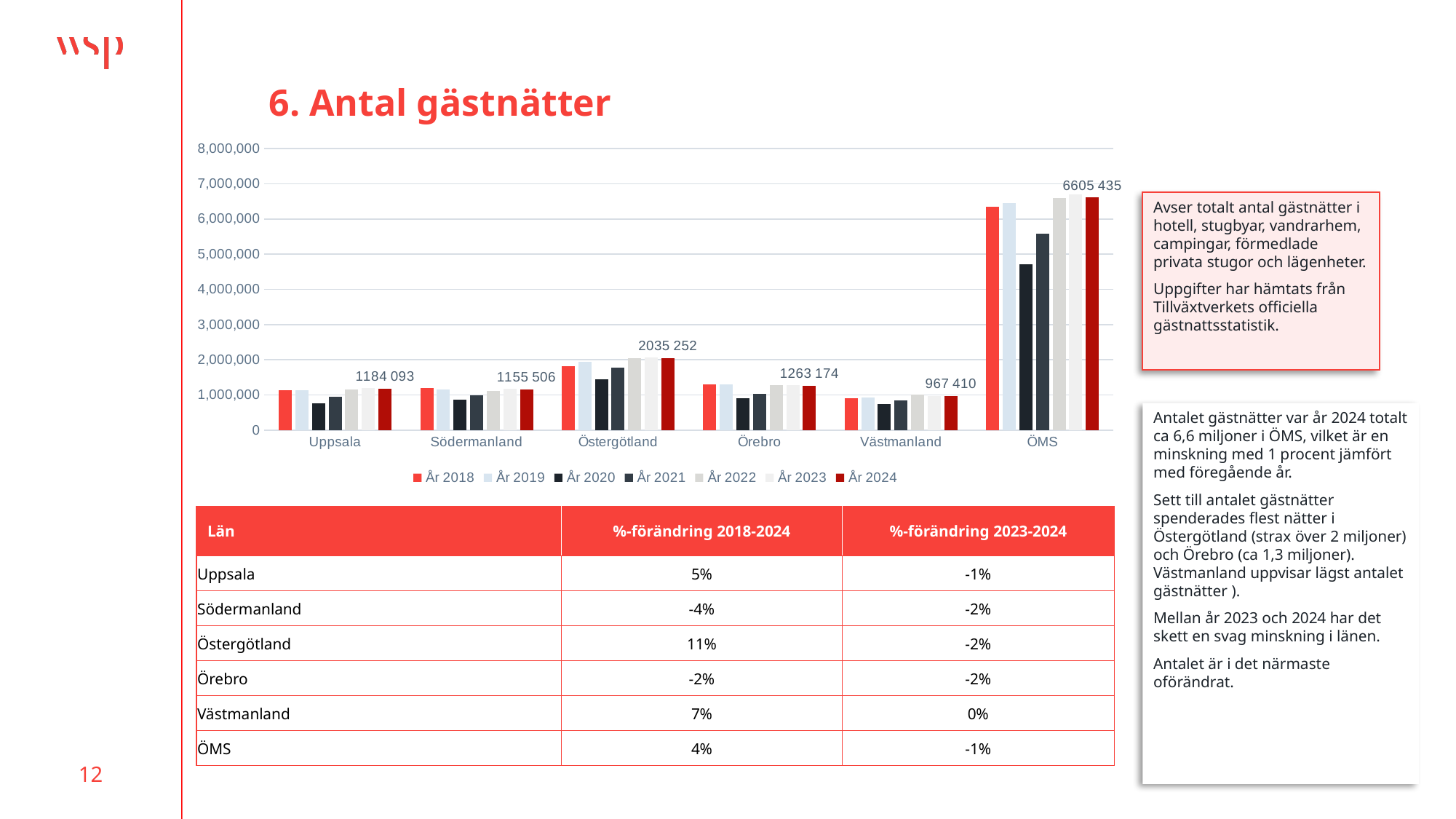
Is the value for ÖMS in År 2020 greater or less than 5,000,000? less What is the value for Östergötland in År 2024? 2035 252 What type of chart is shown on the slide? Bar chart How many series does the chart legend list? 7 What is the title of the chart? 6. Antal gästnätter What is the value for Västmanland in År 2024? 967 410 How many categories are shown on the x axis of the chart? 6 Which is larger in År 2024, Uppsala or Södermanland? Uppsala What is the difference between the År 2024 values for Östergötland and Örebro? 772 078 What is the value for ÖMS in År 2024? 6605 435 Which county (excluding ÖMS) has the highest value in År 2024? Östergötland Which category has the lowest value in År 2024? Västmanland